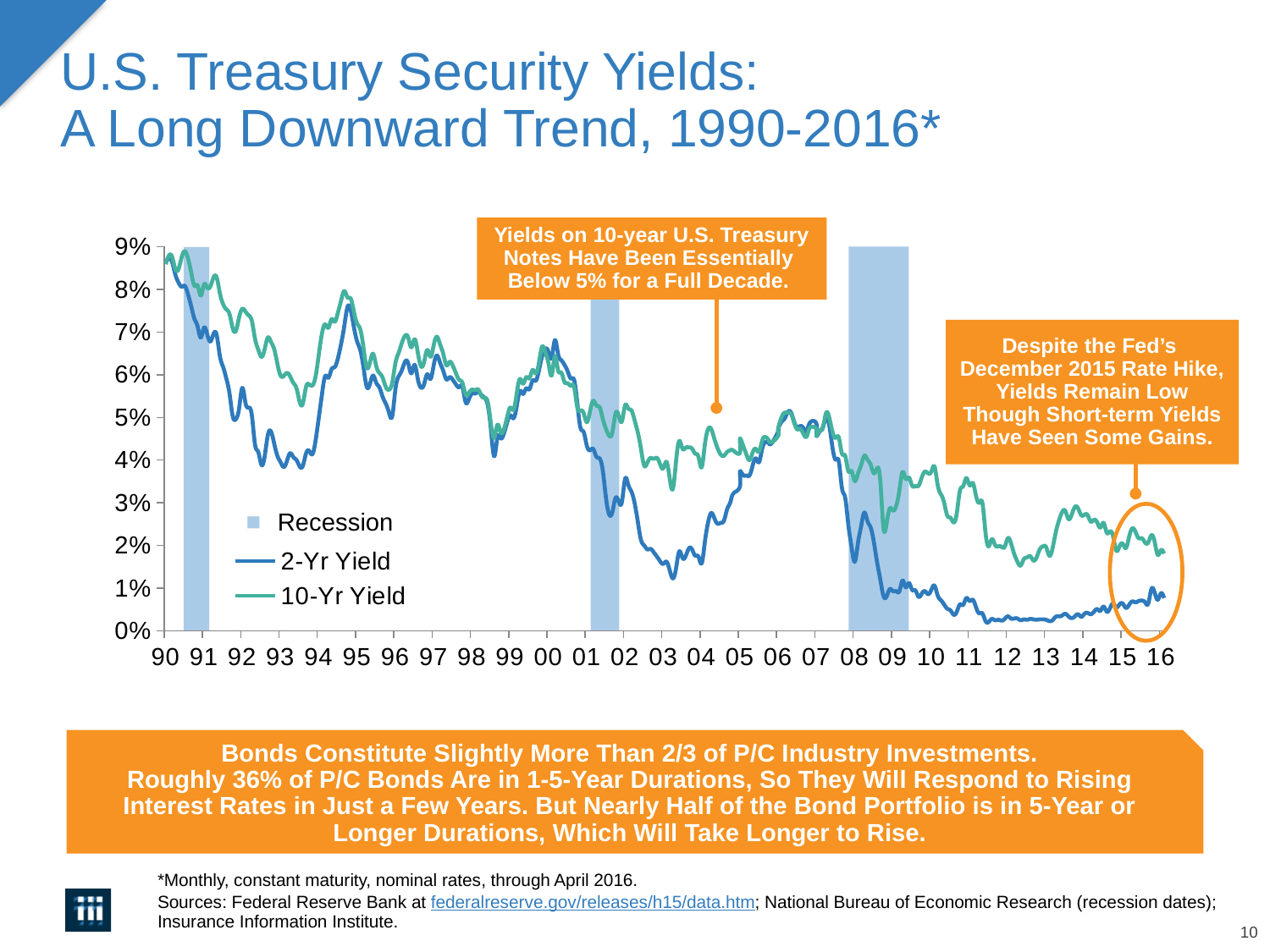
Is the 10-Yr Yield in 2016 greater or less than 3%? less Is the 10-Yr Yield at the start of 1990 greater or less than 8%? greater How many recession periods are shaded on the chart? 3 Is the 2-Yr Yield in 2003 greater or less than 2%? less How many yield series are plotted on the chart? 2 What is the overall trend of the 10-Yr Yield from 1990 to 2016? downward How many entries does the chart's legend list? 3 What is the highest value shown on the chart's vertical axis? 9% What kind of chart is shown on the slide? line chart In 2016, which is higher, the 2-Yr Yield or the 10-Yr Yield? 10-Yr Yield In 2003, which is higher, the 2-Yr Yield or the 10-Yr Yield? 10-Yr Yield